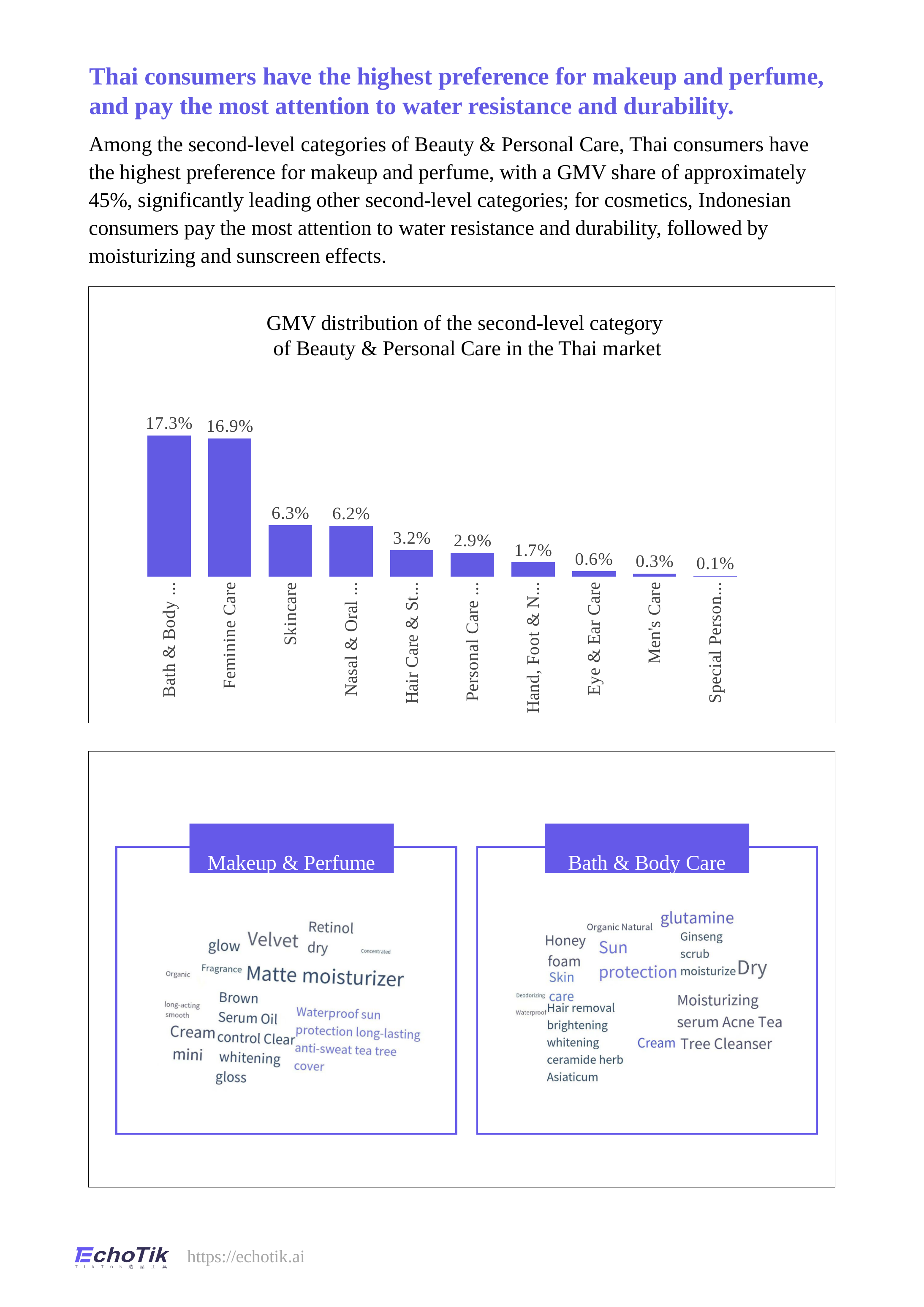
In the GMV distribution chart, which category has the lowest value? Special Person... What type of chart is shown in the 'GMV distribution of the second-level category of Beauty & Personal Care in the Thai market' chart? Bar chart In the GMV distribution chart, which is larger: Skincare or Eye & Ear Care? Skincare In the GMV distribution chart, what is the value for Skincare? 6.3% In the GMV distribution chart, how many bars (categories) are plotted? 10 In the GMV distribution chart, what is the value of the lowest bar? 0.1% In the GMV distribution chart, what is the value for Eye & Ear Care? 0.6% In the GMV distribution chart, what is the value for Feminine Care? 16.9% In the GMV distribution chart, what is the value shown on the first (leftmost) bar? 17.3% In the GMV distribution chart, do the values rise or fall from left to right? Fall In the GMV distribution chart, what is the value for Men's Care? 0.3% In the GMV distribution chart, what is the difference between Feminine Care and Skincare? 10.6%